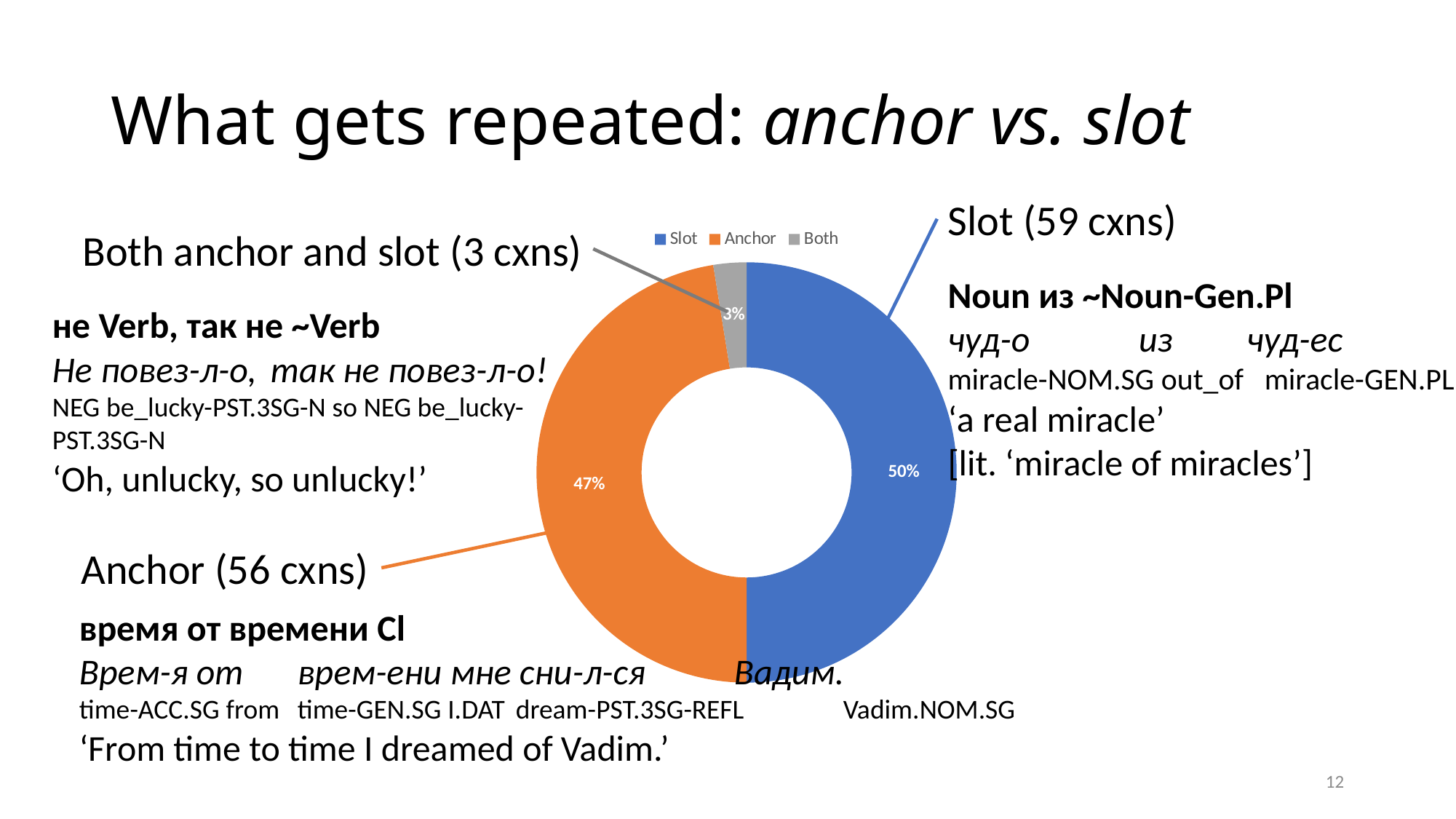
What colour is the Anchor slice in the chart? Orange What percentage of the chart does the Both slice represent? 3% Which slice is larger, Anchor or Both? Anchor What are the legend entries of the chart, in order? Slot, Anchor, Both According to the slide annotation, how many constructions (cxns) does the Anchor slice correspond to? 56 cxns What percentage of the chart does the Anchor slice represent? 47% What percentage of the chart does the Slot slice represent? 50% What kind of chart is shown on the slide? Doughnut (pie) chart What is the difference in percentage points between the Slot and Anchor slices? 3 Which category has the largest share of the chart? Slot Which category has the smallest share of the chart? Both How many categories does the chart show? 3